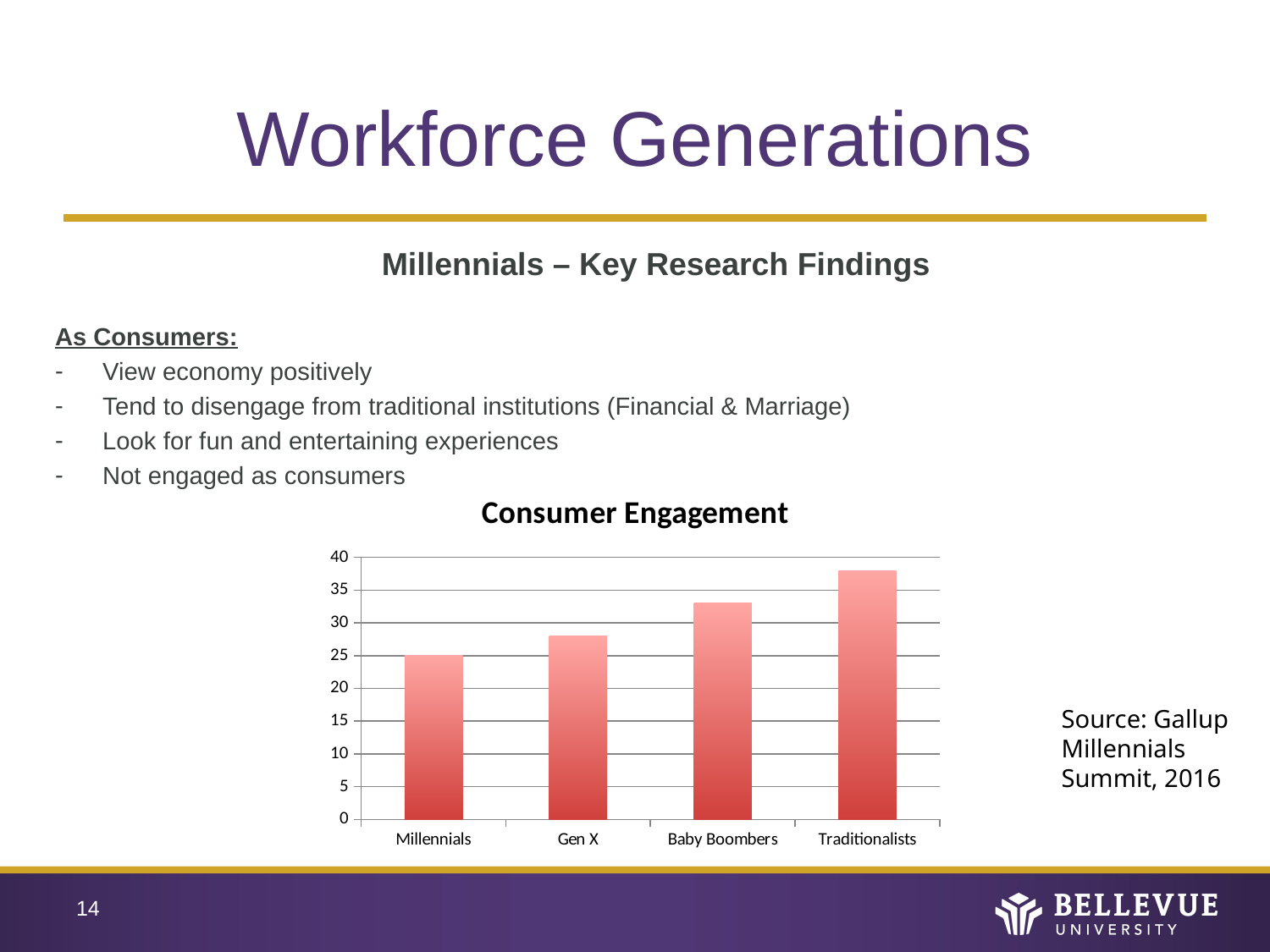
Is the value for Millennials greater or less than 30? less Is the value for Traditionalists greater or less than 35? greater Is the value for Gen X greater or less than 30? less Which category has the lowest value in the Consumer Engagement chart? Millennials How many categories are shown on the x axis of the Consumer Engagement chart? 4 Which category has the highest value in the Consumer Engagement chart? Traditionalists Do the values rise or fall moving from Millennials to Traditionalists along the x axis? rise What is the title of the chart on the slide? Consumer Engagement Which is larger in the Consumer Engagement chart, Baby Boomers or Gen X? Baby Boomers What kind of chart is shown under the title 'Consumer Engagement'? bar chart